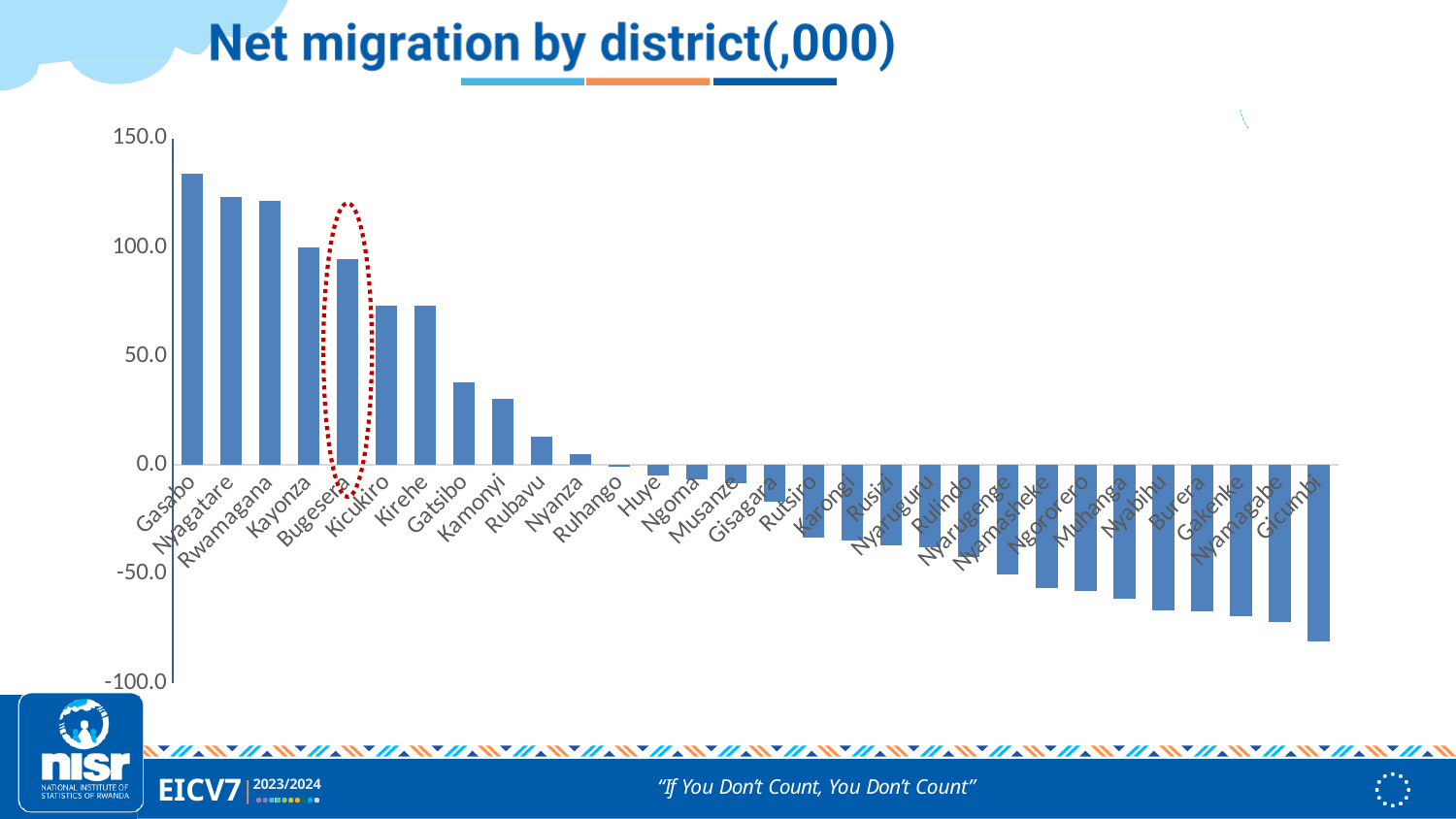
Is the value for Gasabo greater or less than 100.0? greater What kind of chart is shown on the slide? bar chart How many districts are shown on the chart? 30 Which has the larger net migration, Gasabo or Nyagatare? Gasabo Is the value for Gicumbi greater or less than -50.0? less Is the value for Kicukiro greater or less than 50.0? greater Which district has the lowest net migration? Gicumbi What is the title of the chart? Net migration by district(,000) Which district has the highest net migration? Gasabo Do the values rise or fall moving from left to right along the x axis? fall